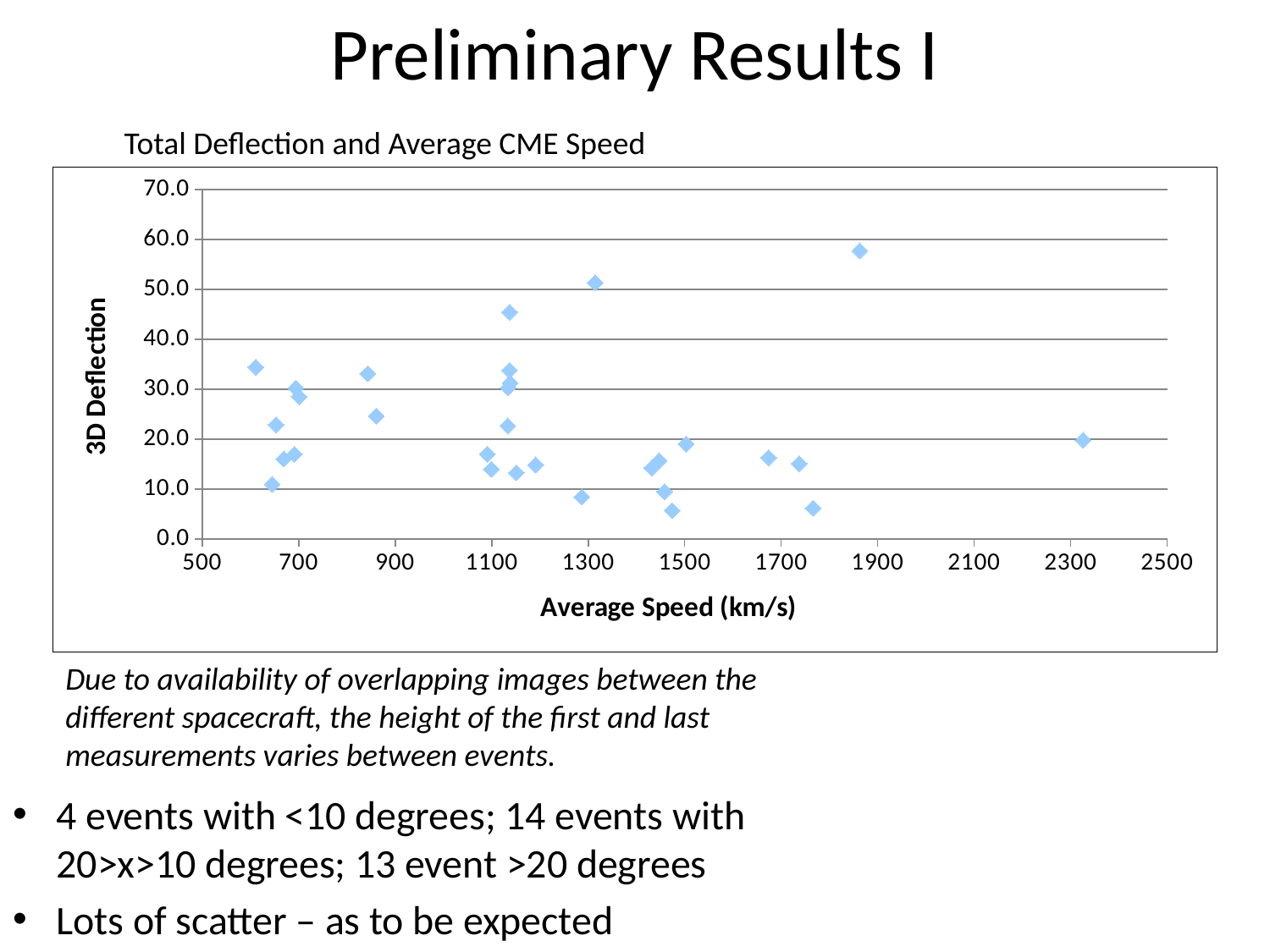
According to the slide, how many events are plotted in total? 31 Which has the larger 3D deflection: the point at about 2300 km/s or the point at about 1860 km/s? the point at about 1860 km/s What is the title of the chart? Total Deflection and Average CME Speed Is the 3D deflection of the point at roughly 600 km/s greater or less than 30? greater What is the label of the x axis of the chart? Average Speed (km/s) Is the average speed of the point with the highest 3D deflection greater or less than 1700 km/s? greater Is the 3D deflection of the point with the highest average speed (around 2300 km/s) greater or less than 30? less Does 3D deflection show a clear rising or falling trend as average speed increases? no clear trend What kind of chart is shown on the slide? scatter chart